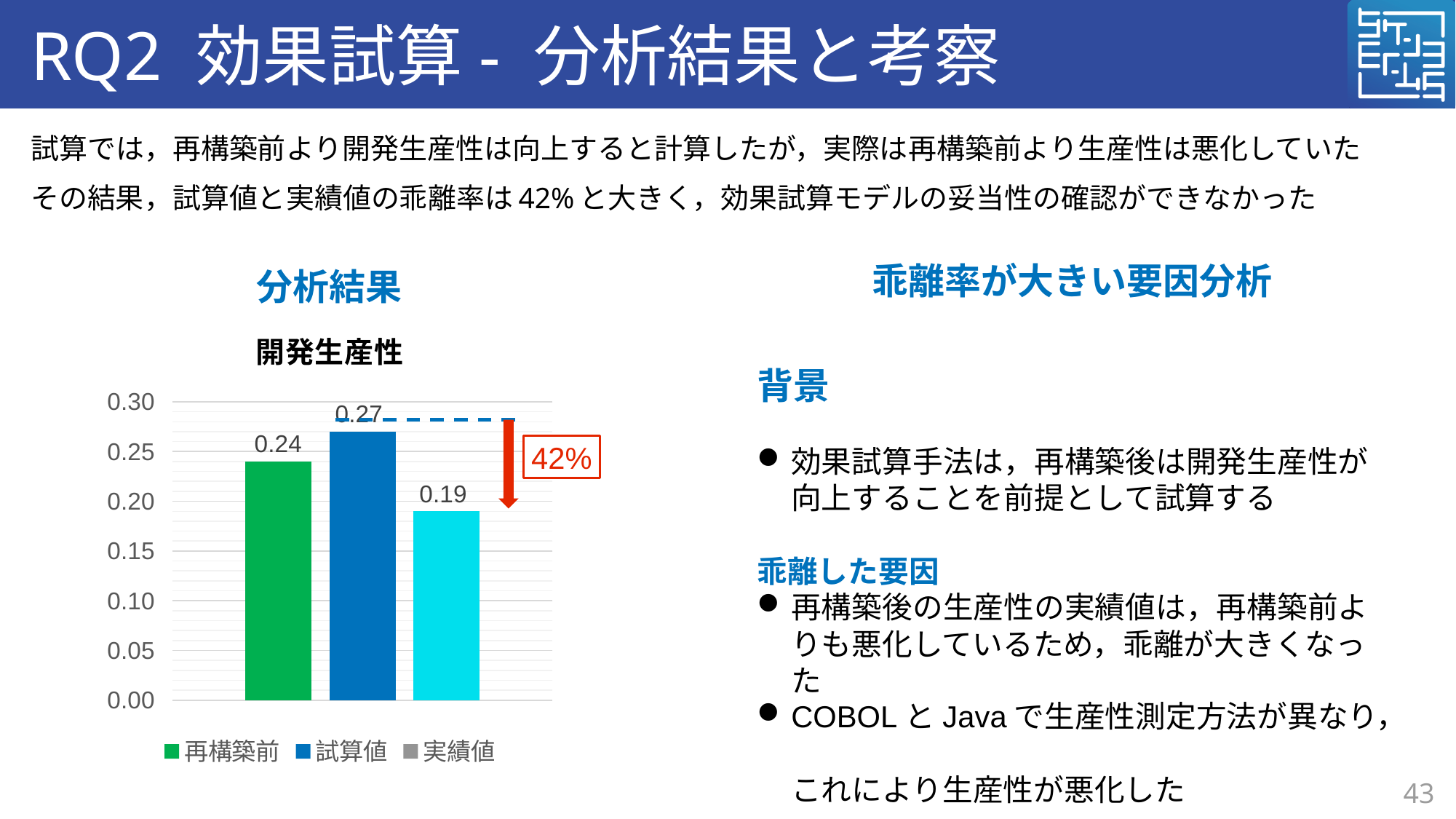
How many series does the legend of the 開発生産性 chart list? 3 What is the difference between the 試算値 and 再構築前 values in the 開発生産性 chart? 0.03 What is the value for 実績値 in the 開発生産性 chart? 0.19 Which series has the lowest value in the 開発生産性 chart? 実績値 What is the value for 試算値 in the 開発生産性 chart? 0.27 What kind of chart is the 開発生産性 chart? bar chart What is the difference between the 試算値 and 実績値 values in the 開発生産性 chart? 0.08 Is the value for 実績値 in the 開発生産性 chart greater or less than 0.20? less In the 開発生産性 chart, which is larger: 再構築前 or 実績値? 再構築前 Which series has the highest value in the 開発生産性 chart? 試算値 How many bars are plotted in the 開発生産性 chart? 3 What is the value for 再構築前 in the 開発生産性 chart? 0.24